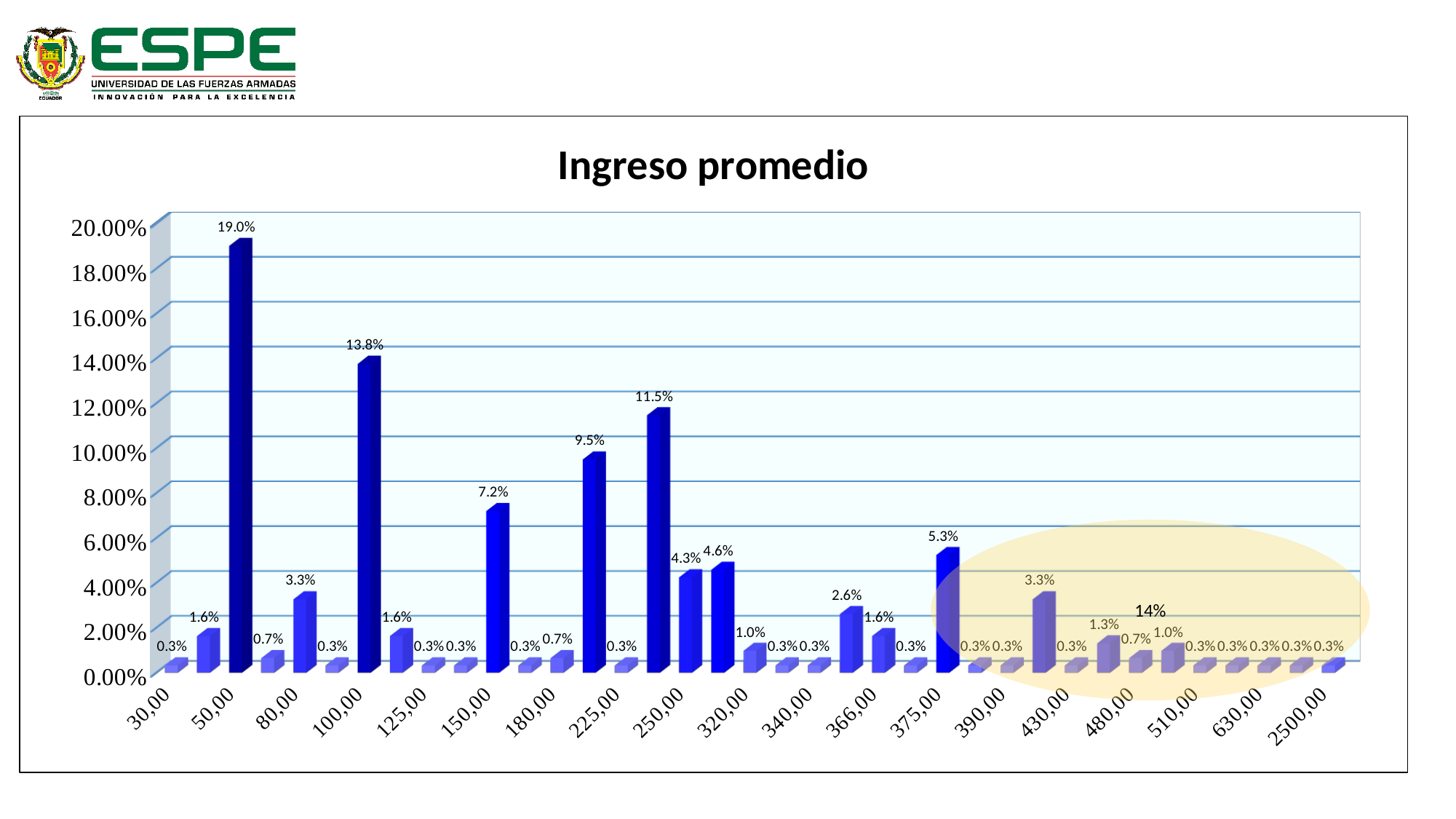
What is the value for the last category, 2500,00? 0.3% What is the value for the first category, 30,00? 0.3% How many category labels are shown on the x axis? 19 What kind of chart is shown on the slide? bar chart What is the highest data label inside the yellow highlighted ellipse? 3.3% What is the highest value shown in the chart? 19.0% What is the maximum value shown on the y axis? 20.00% What is the lowest value shown in the chart? 0.3% What is the second highest value shown in the chart? 13.8% What is the difference between the highest value (19.0%) and the second highest value (13.8%)? 5.2% What is the title of the chart? Ingreso promedio Is the highest bar in the chart greater or less than 18.00%? greater